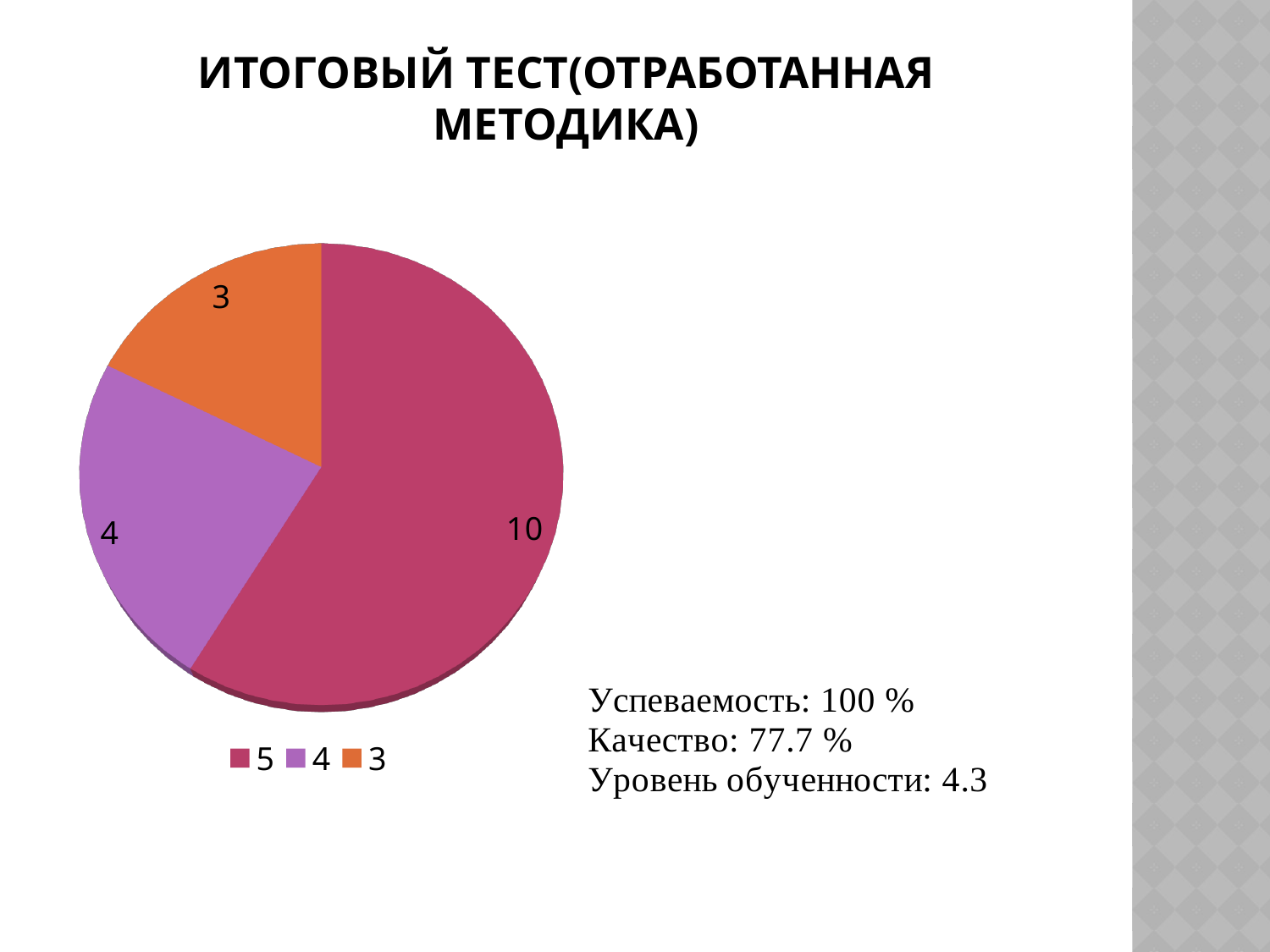
What type of chart is shown on the slide? pie chart What is the value of the slice for grade 4? 4 Which grade has the largest slice in the pie chart? 5 What is the value of the slice for grade 5? 10 Which grade has the smallest slice in the pie chart? 3 Which is larger, the slice for grade 5 or the slice for grade 3? grade 5 What is the difference between the value for grade 5 and the value for grade 4? 6 What is the title of the chart on the slide? ИТОГОВЫЙ ТЕСТ(ОТРАБОТАННАЯ МЕТОДИКА) How many slices does the pie chart have? 3 What is the difference between the value for grade 4 and the value for grade 3? 1 What is the value of the slice for grade 3? 3 How many entries does the legend list? 3